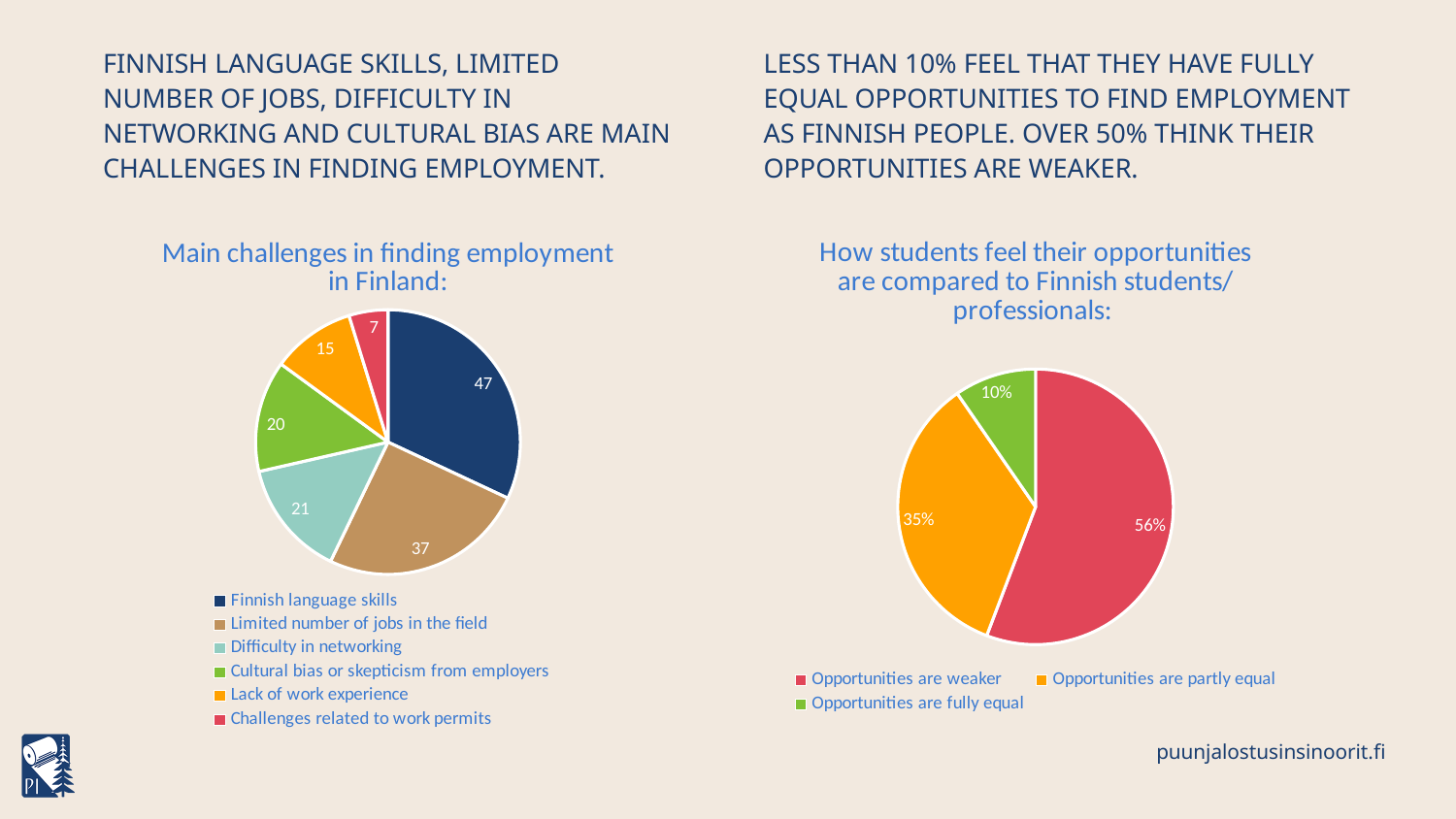
In the 'Main challenges in finding employment in Finland' chart, what is the value for Lack of work experience? 15 In the 'How students feel their opportunities are compared to Finnish students/professionals' chart, what share of the pie is 'Opportunities are weaker'? 56% In the 'Main challenges in finding employment in Finland' chart, which category has the lowest value? Challenges related to work permits In the 'How students feel their opportunities are compared to Finnish students/professionals' chart, what is the value for 'Opportunities are fully equal'? 10% In the 'Main challenges in finding employment in Finland' chart, which category has the highest value? Finnish language skills How many entries does the legend of the 'How students feel their opportunities are compared to Finnish students/professionals' chart list? 3 In the 'How students feel their opportunities are compared to Finnish students/professionals' chart, what is the difference between 'Opportunities are weaker' and 'Opportunities are partly equal'? 21% In the 'Main challenges in finding employment in Finland' chart, which is larger: Difficulty in networking or Lack of work experience? Difficulty in networking What type of chart is the 'Main challenges in finding employment in Finland' chart? Pie chart How many categories does the 'Main challenges in finding employment in Finland' chart show? 6 In the 'Main challenges in finding employment in Finland' chart, what is the value for Finnish language skills? 47 In the 'Main challenges in finding employment in Finland' chart, what is the difference between Finnish language skills and Limited number of jobs in the field? 10